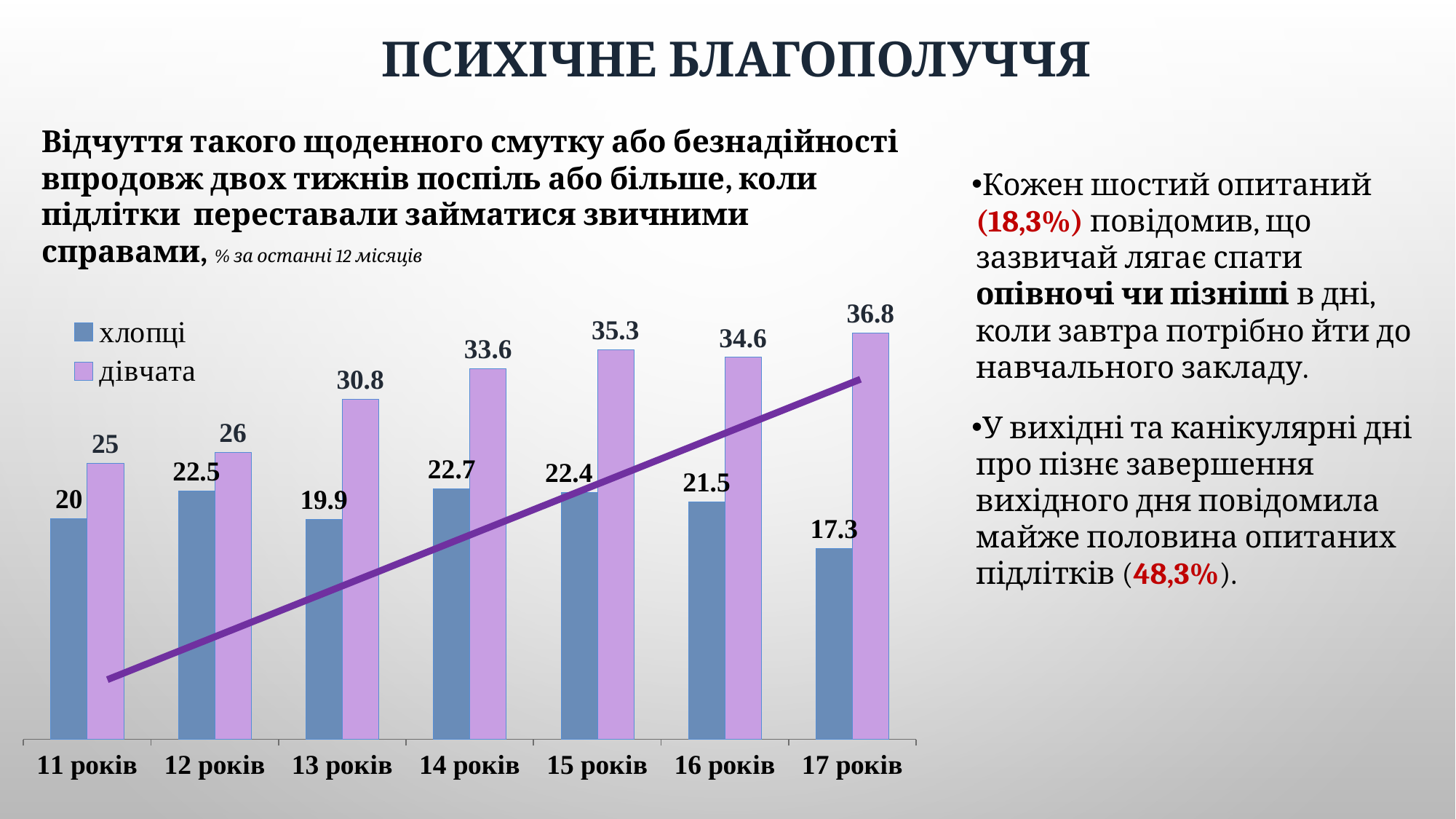
Which is larger at 12 років: хлопці or дівчата? дівчата How many series does the legend list? 2 Do the values for дівчата generally rise or fall from 11 років to 17 років? rise Which age group has the highest value for дівчата? 17 років What is the value for дівчата at 14 років? 33.6 What is the value for хлопці at 13 років? 19.9 What is the difference between дівчата and хлопці at 17 років? 19.5 What is the difference between дівчата at 15 років and дівчата at 11 років? 10.3 What is the value for дівчата at 17 років? 36.8 Which age group has the lowest value for хлопці? 17 років How many age categories are shown on the x axis? 7 What kind of chart is shown on the slide? bar chart